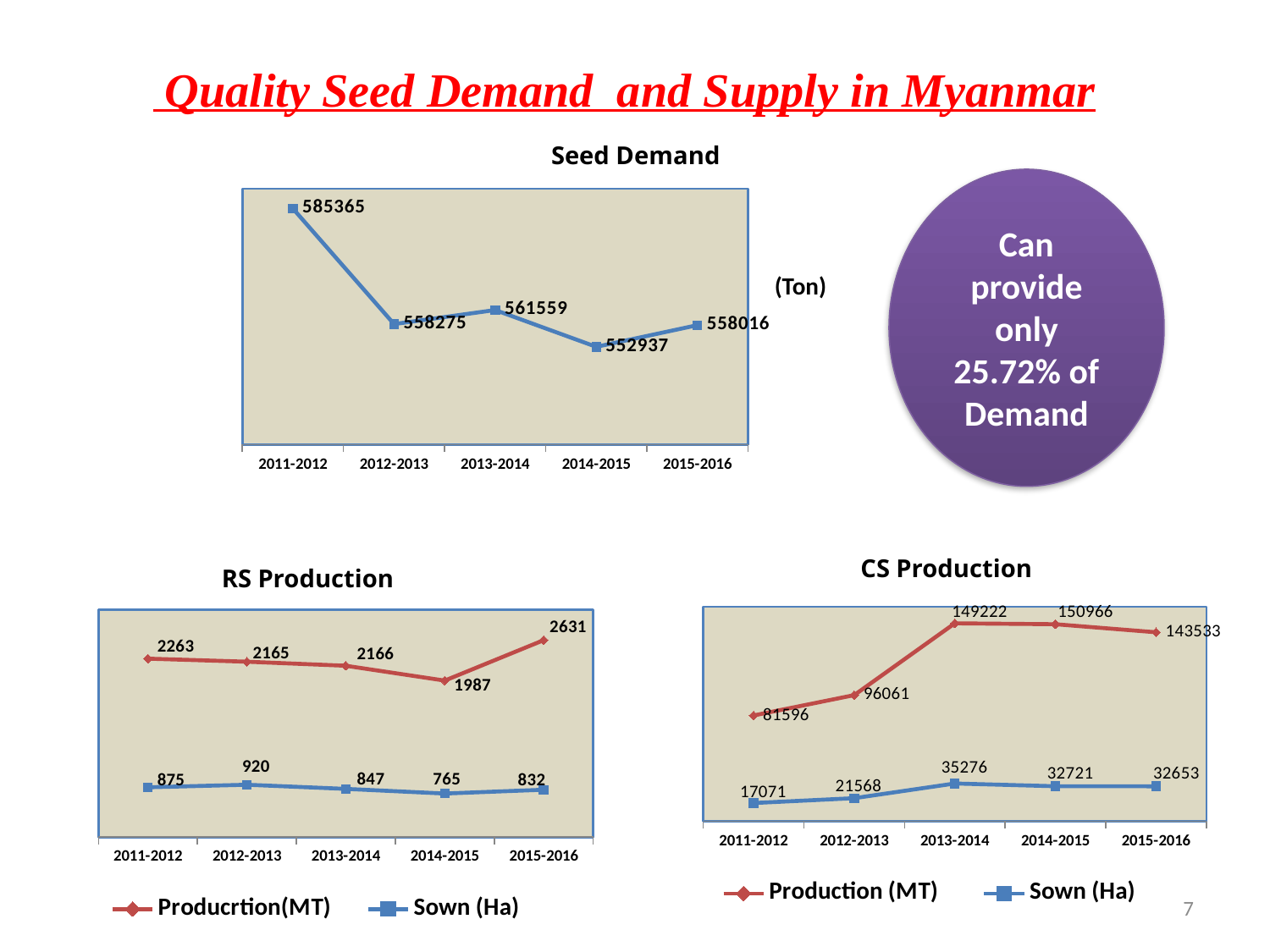
In the Seed Demand chart, how many years are plotted on the x axis? 5 In the RS Production chart, what is the Producrtion(MT) value for 2015-2016? 2631 In the Seed Demand chart, what is the seed demand for 2011-2012? 585365 In the RS Production chart, which year has the highest Sown (Ha) value? 2012-2013 In the Seed Demand chart, what is the difference between the seed demand in 2011-2012 and 2012-2013? 27090 In the RS Production chart, how many series does the legend list? 2 In the Seed Demand chart, which year has the lowest seed demand? 2014-2015 In the CS Production chart, is the Sown (Ha) value for 2011-2012 larger or smaller than the Sown (Ha) value for 2015-2016? Smaller In the CS Production chart, which year has the highest Production (MT) value? 2014-2015 In the CS Production chart, what is the difference between the Sown (Ha) values for 2013-2014 and 2012-2013? 13708 In the CS Production chart, what is the Production (MT) value for 2013-2014? 149222 What kind of chart is the RS Production chart? Line chart